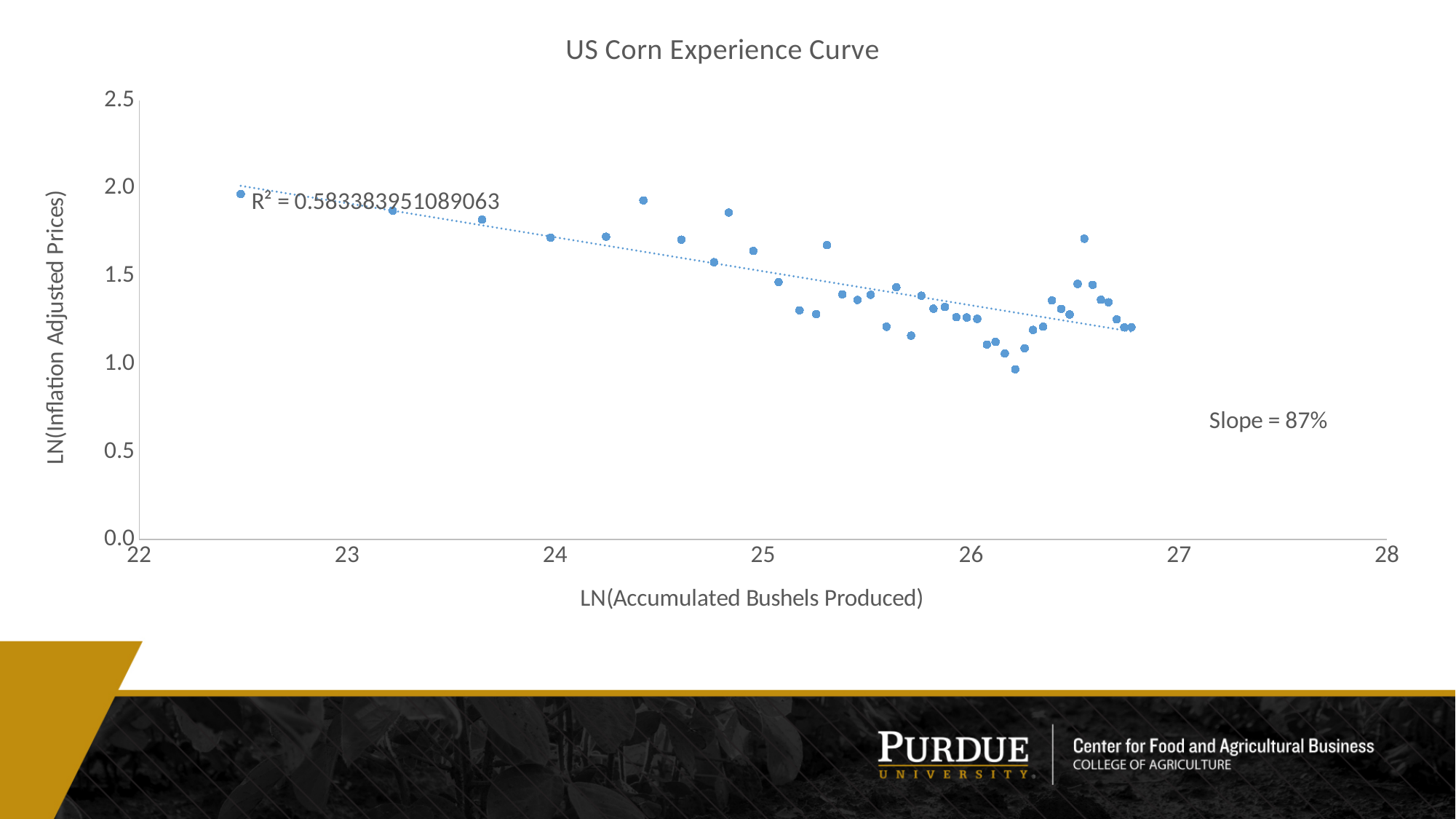
Is the value of the point near x = 24.4 (the highest point in the middle of the chart) greater or less than 1.5? greater Is the leftmost point higher or lower than the rightmost point? higher What R² value is printed on the chart? 0.583383951089063 What slope value is annotated on the chart? 87% What is the highest value shown on the x axis? 28 What kind of chart is shown on the slide? scatter plot What is the highest value shown on the y axis? 2.5 What is the label of the x axis? LN(Accumulated Bushels Produced) Is the value of the lowest point (near x = 26.2) greater or less than 1.5? less Is the value of the leftmost point (near x = 22.5) greater or less than 1.5? greater Do the plotted values generally rise or fall as LN(Accumulated Bushels Produced) increases? fall What is the title of the chart? US Corn Experience Curve